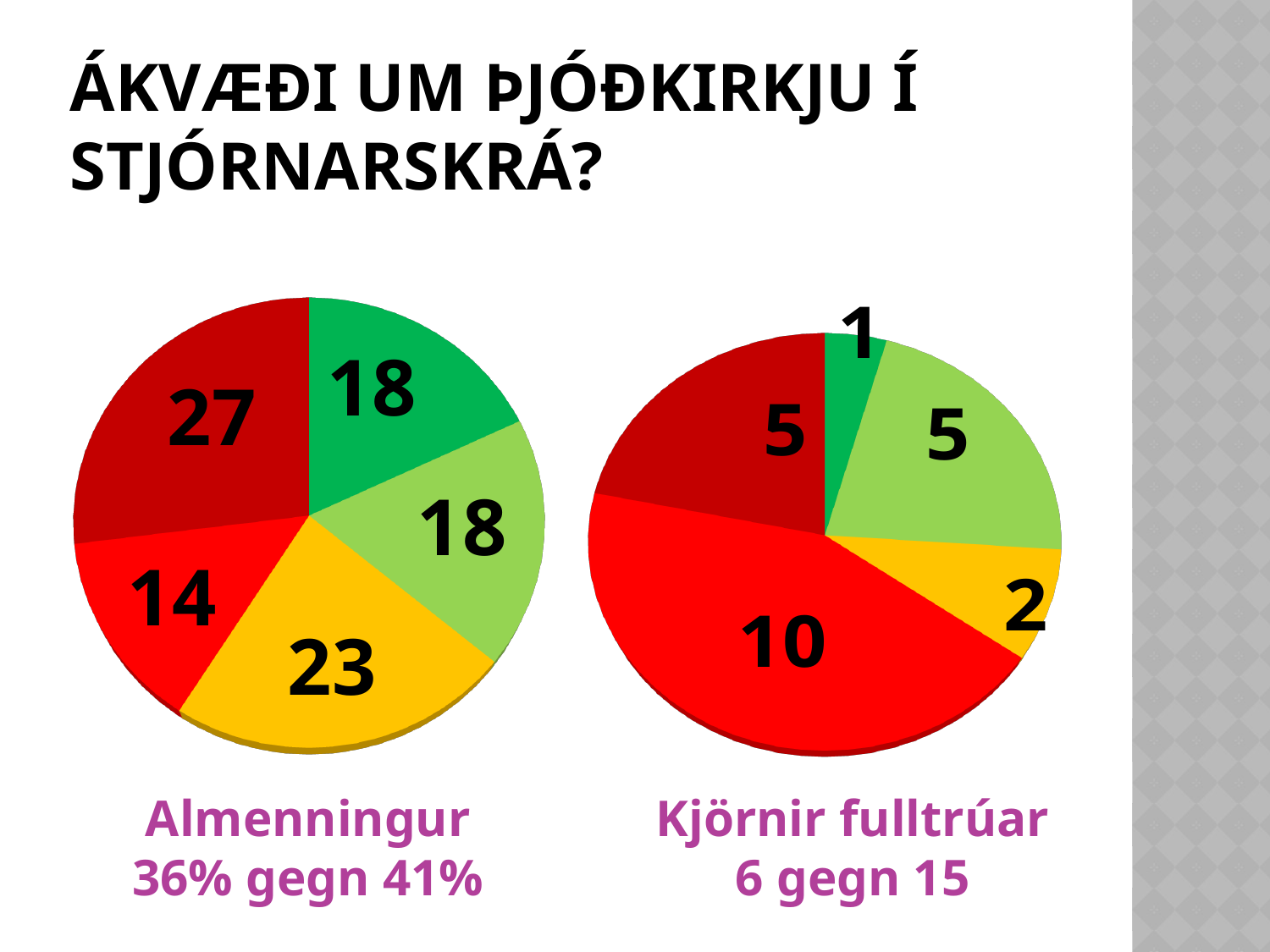
What kind of chart is the "Almenningur" chart on the left? pie chart In the "Almenningur" pie chart on the left, what is the value of the yellow slice? 23 In the "Kjörnir fulltrúar" pie chart on the right, which slice has the smallest value? the dark green slice (1) In the "Kjörnir fulltrúar" pie chart on the right, what is the value of the bright red slice? 10 In the "Kjörnir fulltrúar" pie chart on the right, is the light green slice or the yellow slice larger? the light green slice In the "Almenningur" pie chart on the left, what share of the total does the yellow slice (23) represent? 23% In the "Kjörnir fulltrúar" pie chart on the right, what is the value of the yellow slice? 2 In the "Almenningur" pie chart on the left, what is the difference between the dark red slice and the bright red slice? 13 In the "Almenningur" pie chart on the left, what is the value of the dark red slice? 27 What is the total of all slices in the "Kjörnir fulltrúar" pie chart on the right? 23 How many slices does the "Kjörnir fulltrúar" pie chart on the right have? 5 In the "Almenningur" pie chart on the left, which slice has the largest value? the dark red slice (27)